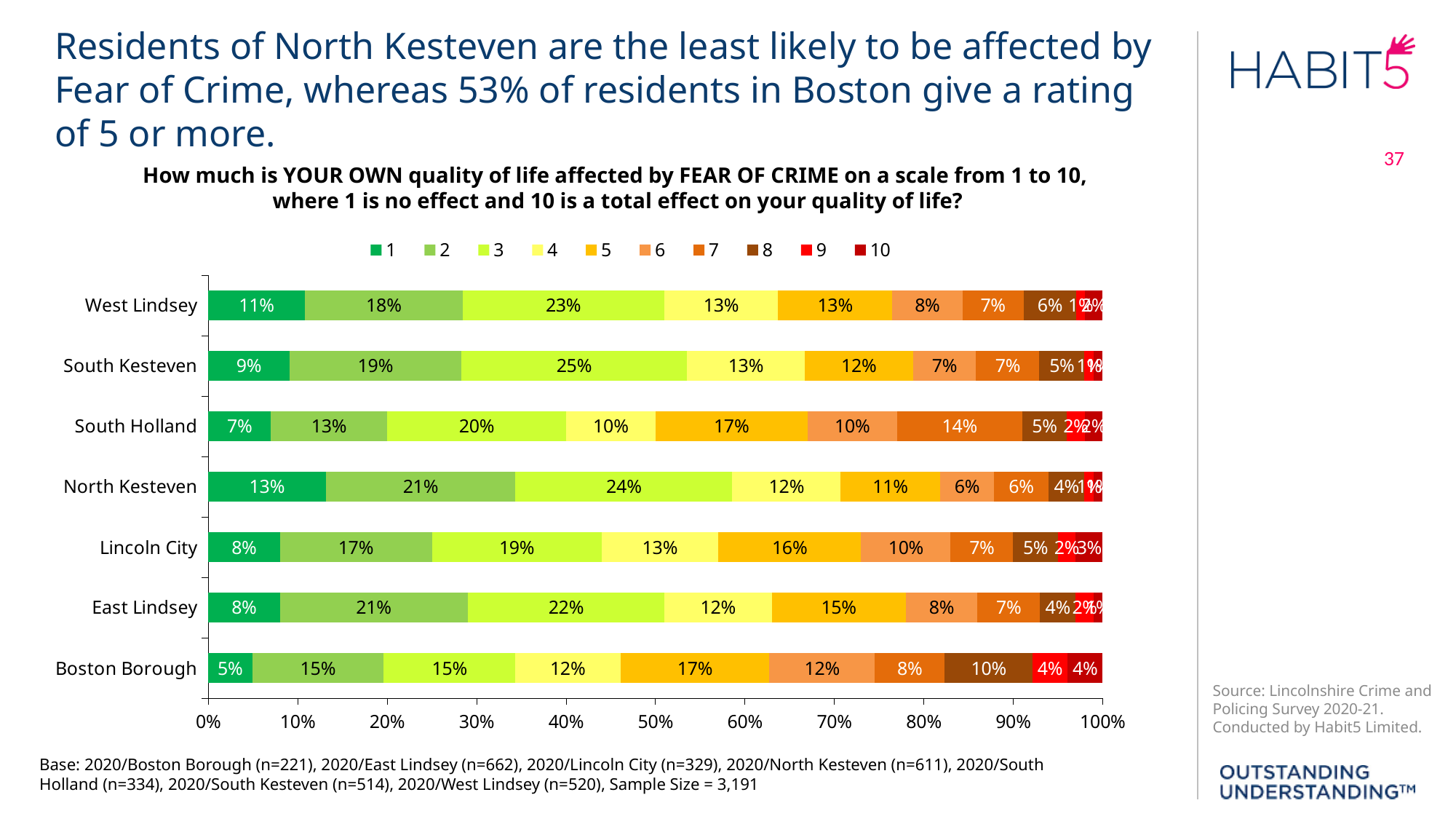
How many districts are shown on the chart? 7 How many series does the legend list? 10 What kind of chart is shown on the slide? Stacked bar chart Which is larger: the rating 5 share for South Holland or for North Kesteven? South Holland Which district has the highest percentage of residents giving a rating of 8? Boston Borough Which district has the highest percentage of residents giving a rating of 1? North Kesteven What is the difference in percentage points between the rating 3 share for South Kesteven and for Boston Borough? 10 percentage points What is the difference in percentage points between the rating 2 share for North Kesteven and for West Lindsey? 3 percentage points Which district has the lowest percentage of residents giving a rating of 1? Boston Borough What percentage of North Kesteven residents gave a rating of 3? 24% What percentage of Boston Borough residents gave a rating of 1? 5% What percentage of South Holland residents gave a rating of 7? 14%